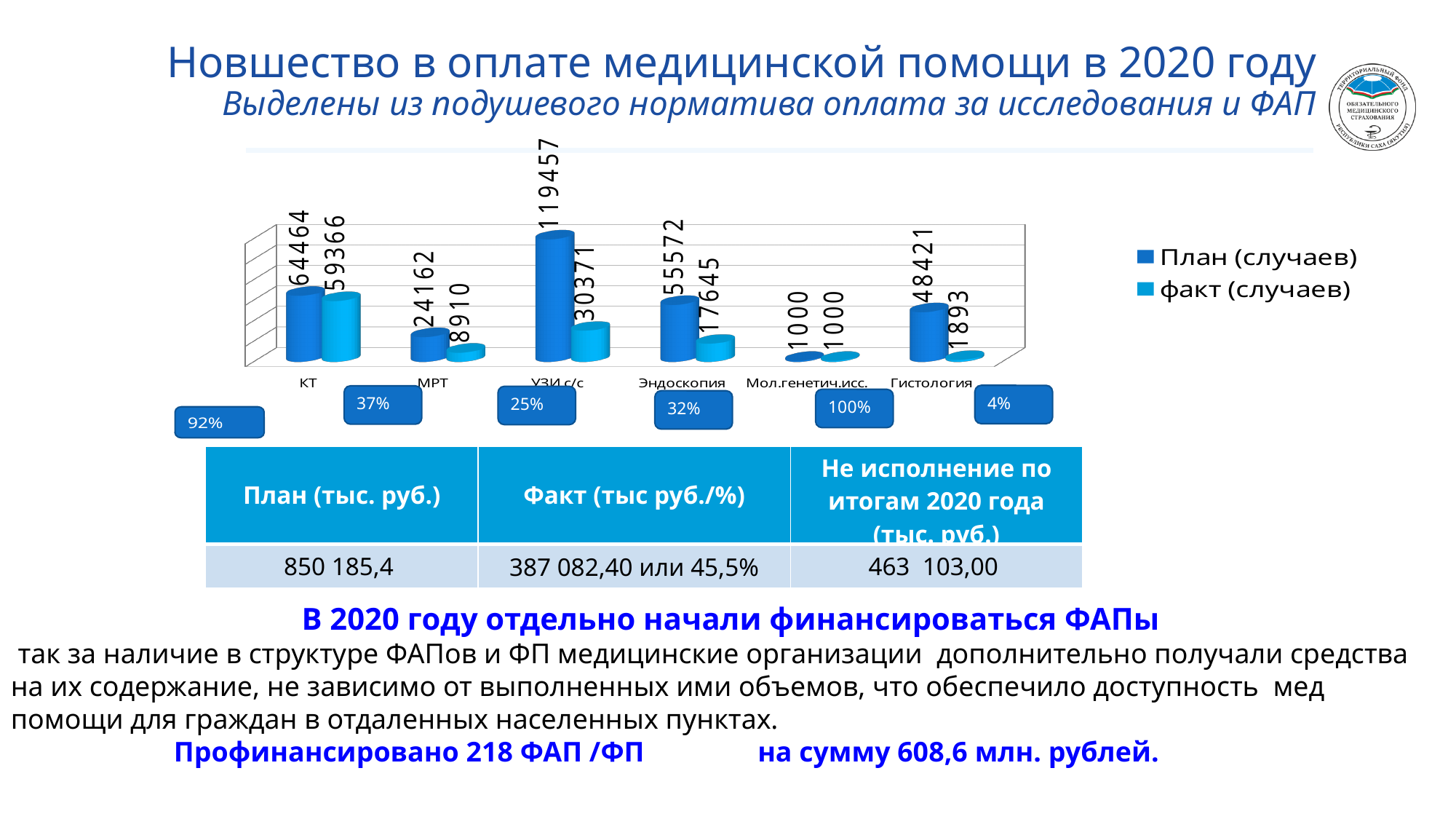
What type of chart is shown on the slide? bar chart Which is larger for Эндоскопия: the План (случаев) value or the факт (случаев) value? План (случаев) What is the факт (случаев) value for УЗИ с/с? 30371 Which category has the lowest факт (случаев) value? Мол.генетич.исс. How many categories are shown on the chart's x axis? 6 What is the difference between the План (случаев) values for УЗИ с/с and КТ? 54993 What is the План (случаев) value for КТ? 64464 How many series does the chart legend list? 2 What is the difference between the План (случаев) and факт (случаев) values for МРТ? 15252 What are the two legend entries of the chart? План (случаев) and факт (случаев) What is the факт (случаев) value for Гистология? 1893 Which category has the highest План (случаев) value? УЗИ с/с